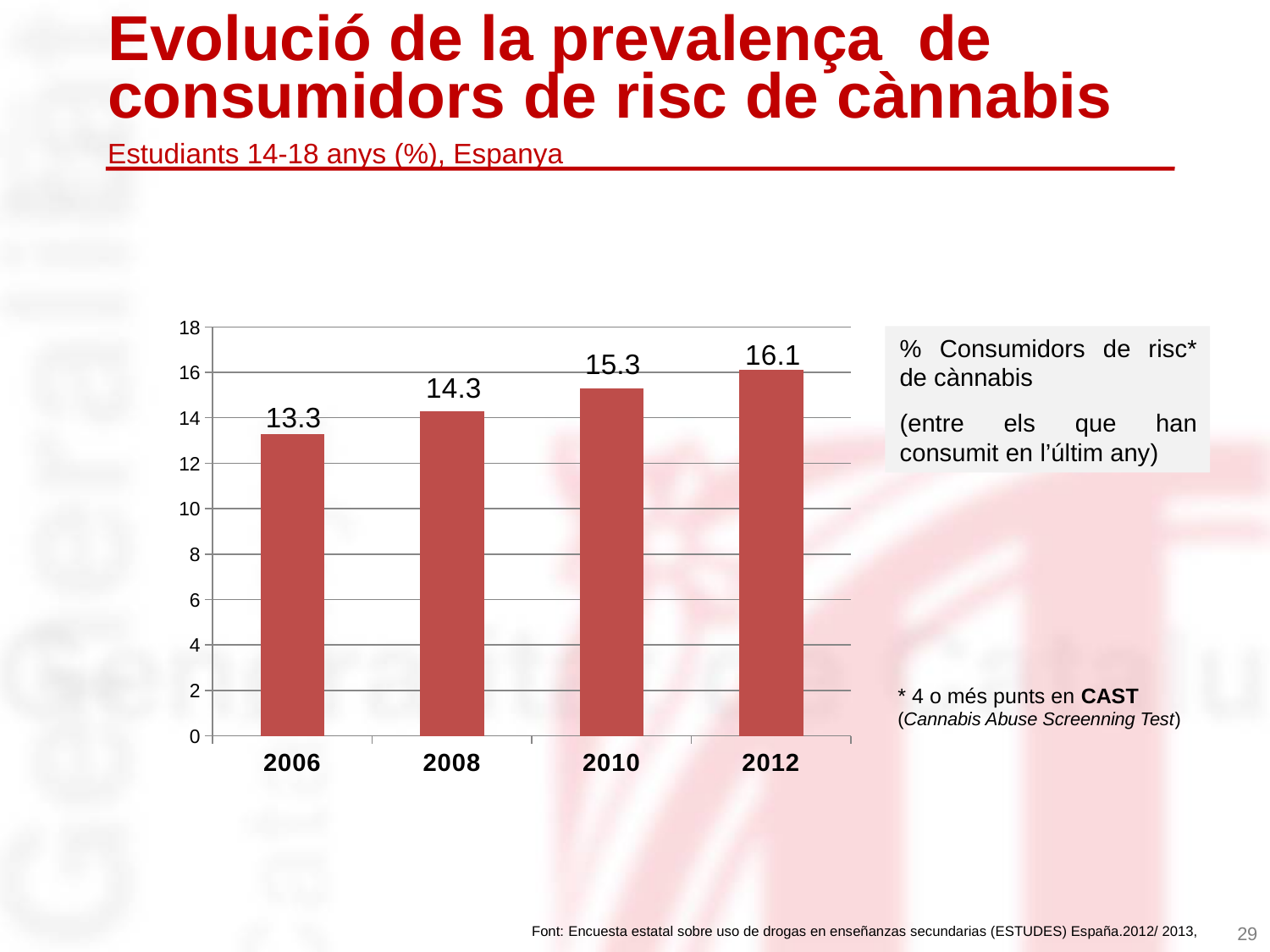
Which year has the highest value? 2012 What kind of chart is shown on the slide? bar chart What is the difference between the values for 2012 and 2006? 2.8 How many years are shown on the x axis? 4 Which year has the lowest value? 2006 Which is larger, the value for 2008 or the value for 2010? 2010 What is the value for 2006? 13.3 Is the value for 2012 greater or less than 16? greater What is the value for 2012? 16.1 Do the values rise or fall from 2006 to 2012? rise What is the difference between the values for 2010 and 2008? 1.0 What is the value for 2010? 15.3